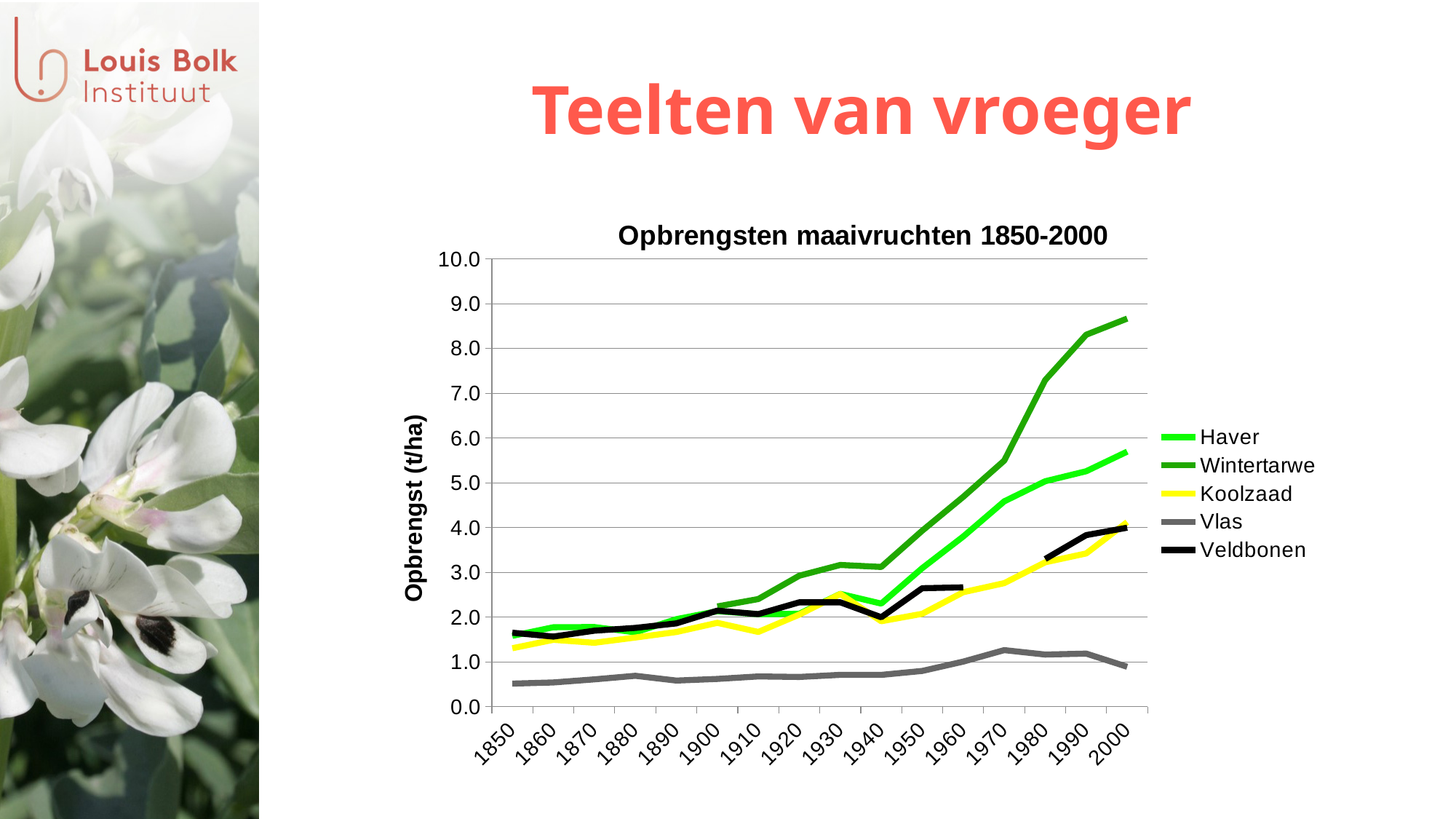
How many years are marked along the x axis? 16 How many series does the legend list? 5 What is the label of the y axis? Opbrengst (t/ha) What kind of chart is shown on the slide? line chart Which is larger in 2000, the value for Wintertarwe or the value for Haver? Wintertarwe Which series has the highest value in 2000? Wintertarwe Is the value for Haver in 2000 greater or less than 5.0? greater Is the value for Vlas in 1850 greater or less than 1.0? less What is the title of the chart? Opbrengsten maaivruchten 1850-2000 Is the value for Wintertarwe in 2000 greater or less than 8.0? greater Which series has the lowest value in 2000? Vlas